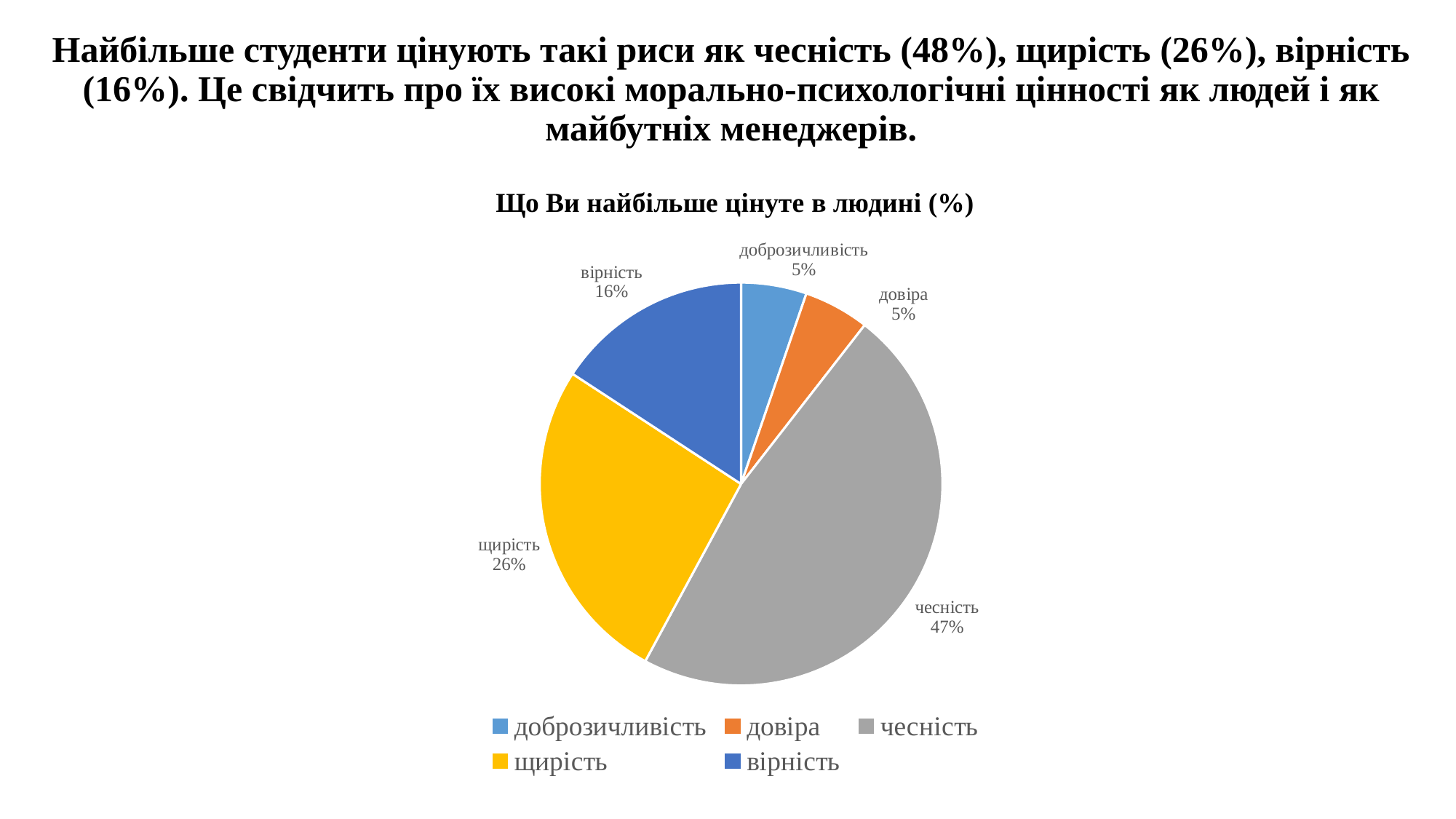
What percentage is shown for довіра? 5% What is the difference in percentage points between чесність and щирість? 21 What colour is the slice for щирість? yellow What percentage is shown for вірність? 16% How many entries does the legend list? 5 What kind of chart is shown on the slide? pie chart What percentage is shown for чесність? 47% Which category has the largest slice of the pie? чесність What is the title of the chart? Що Ви найбільше цінуте в людині (%) Which is larger, the slice for вірність or the slice for доброзичливість? вірність What percentage is shown for щирість? 26% How many slices does the pie chart have? 5